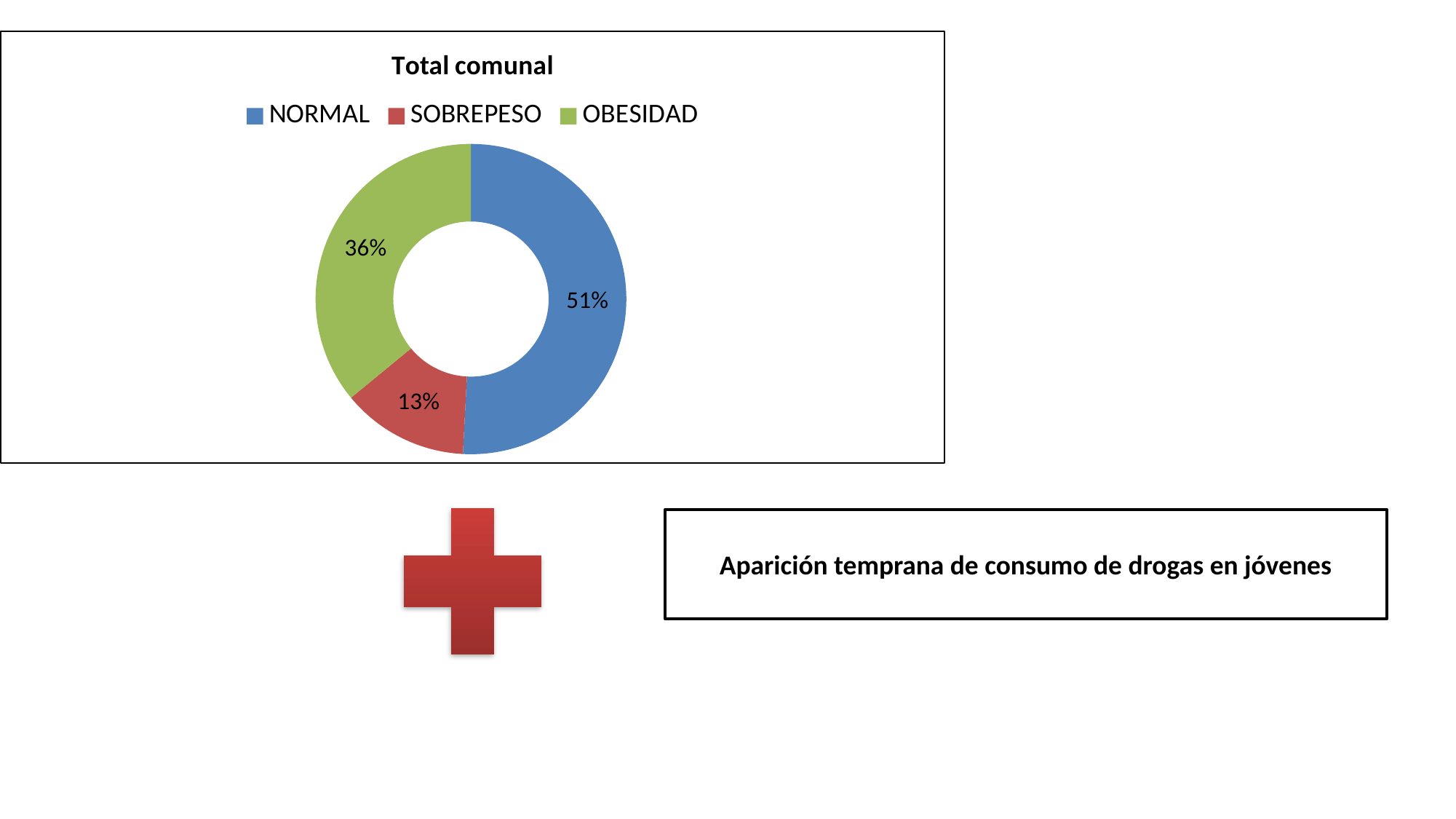
Which category has the largest share in the 'Total comunal' chart? NORMAL What percentage of the 'Total comunal' chart is OBESIDAD? 36% What kind of chart is 'Total comunal'? Doughnut chart What colour represents OBESIDAD in the 'Total comunal' chart? Green What is the title of the chart on the slide? Total comunal Which category has the smallest share in the 'Total comunal' chart? SOBREPESO What is the difference in percentage points between OBESIDAD and SOBREPESO in the 'Total comunal' chart? 23 What percentage of the 'Total comunal' chart is SOBREPESO? 13% What percentage of the 'Total comunal' chart is NORMAL? 51% What is the difference in percentage points between NORMAL and OBESIDAD in the 'Total comunal' chart? 15 How many categories are shown in the 'Total comunal' chart? 3 Which is larger in the 'Total comunal' chart, OBESIDAD or SOBREPESO? OBESIDAD